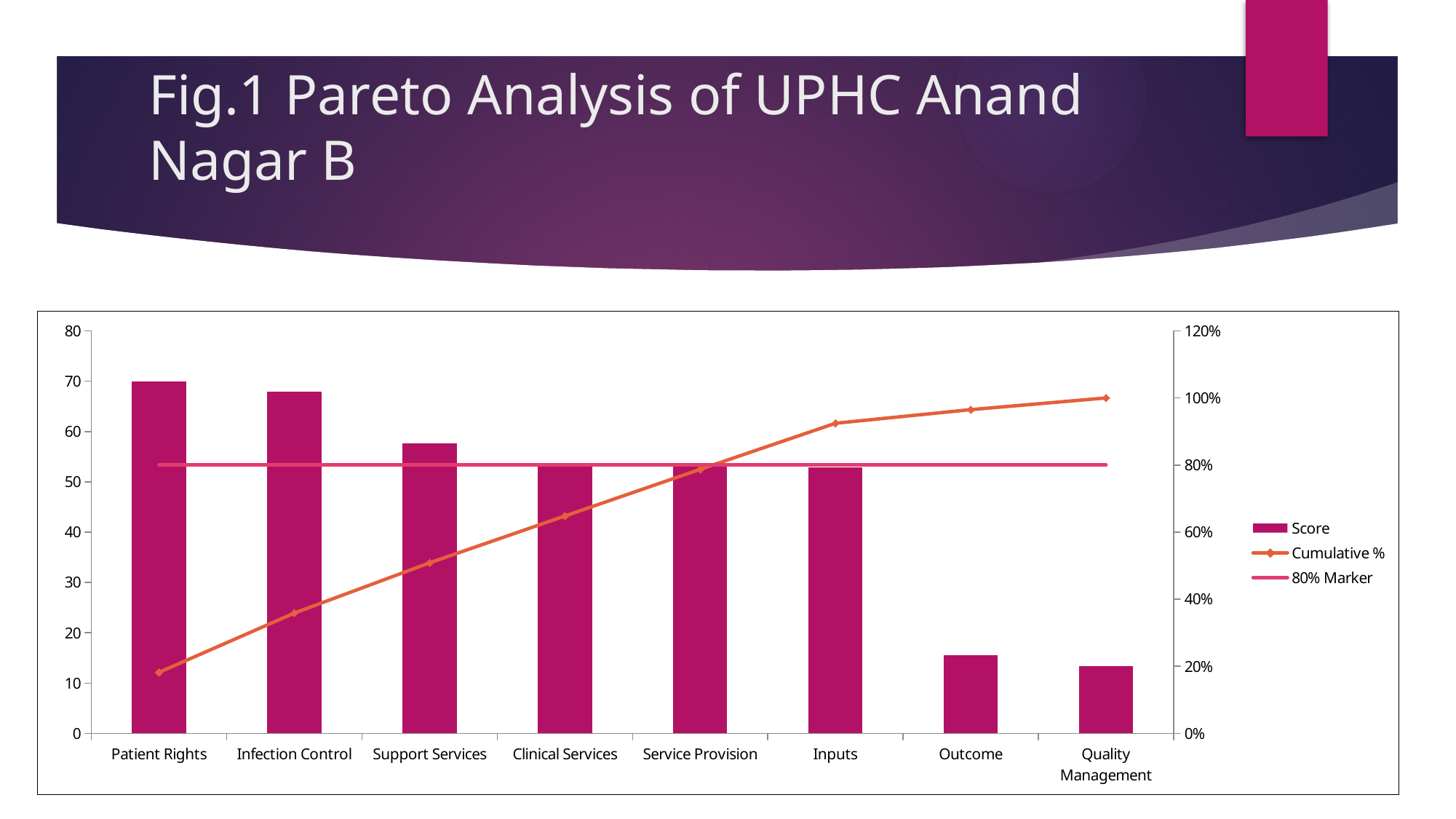
How many categories are shown along the x axis? 8 How many series does the legend list? 3 Which has a larger Score, Patient Rights or Outcome? Patient Rights Is the Score for Support Services greater or less than 50? greater Is the Score for Outcome greater or less than 20? less Which category has the lowest Score bar? Quality Management What kind of chart is shown on the slide? A bar chart combined with a line chart What are the three entries listed in the legend? Score, Cumulative %, 80% Marker Does the Cumulative % line rise or fall from left to right? rise Which category has the highest Score bar? Patient Rights Do the Score bars rise or fall from left to right along the x axis? fall Is the Score for Infection Control greater or less than 60? greater